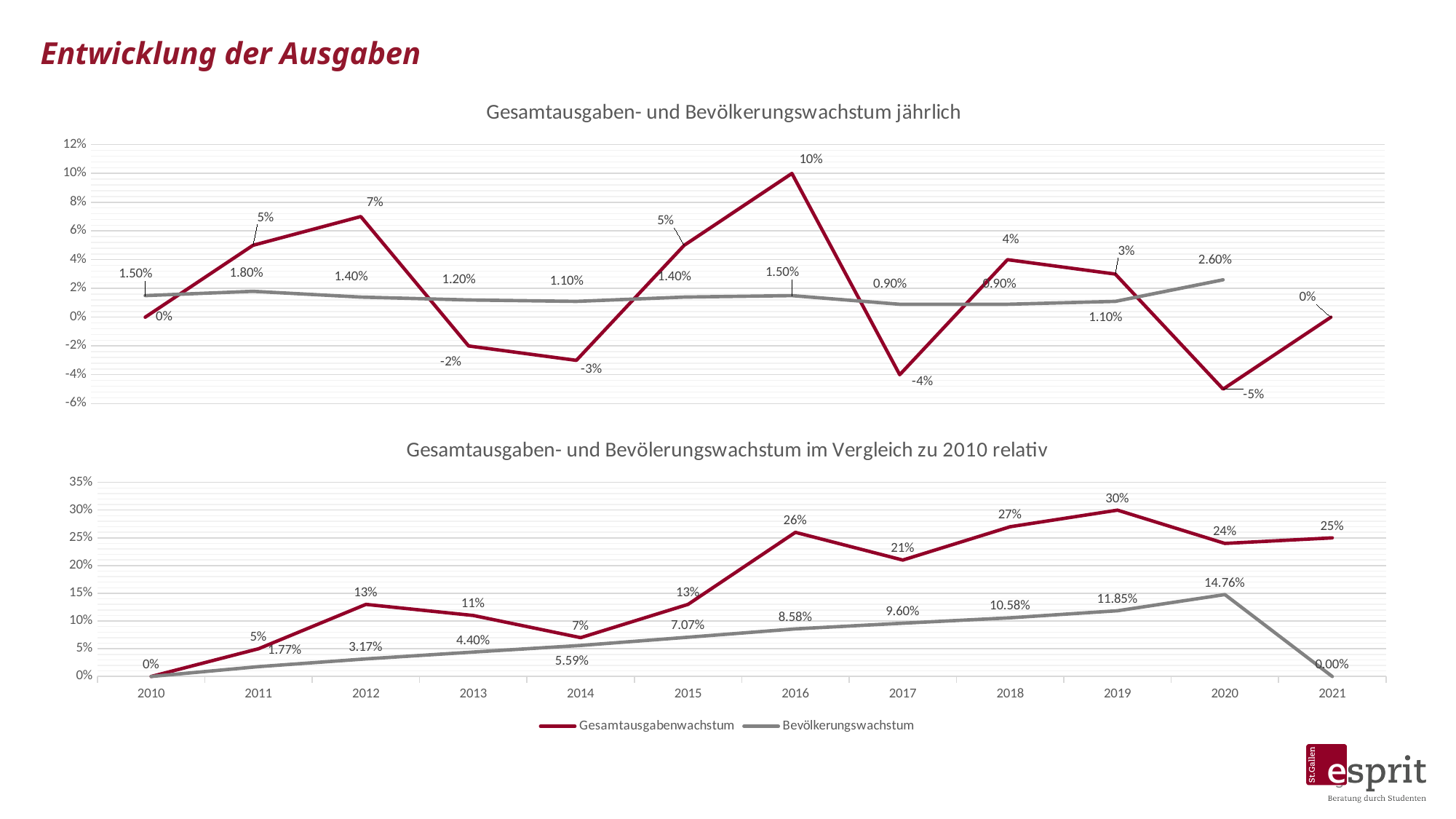
How many series does the legend list? 2 In the top chart (Gesamtausgaben- und Bevölkerungswachstum jährlich), which year has the lowest Gesamtausgabenwachstum? 2020 In the bottom chart (Gesamtausgaben- und Bevölerungswachstum im Vergleich zu 2010 relativ), what is the difference between Gesamtausgabenwachstum and Bevölkerungswachstum in 2020? 9.24 percentage points In the bottom chart (Gesamtausgaben- und Bevölerungswachstum im Vergleich zu 2010 relativ), which is larger in 2017: Gesamtausgabenwachstum or Bevölkerungswachstum? Gesamtausgabenwachstum In the top chart (Gesamtausgaben- und Bevölkerungswachstum jährlich), what is the Bevölkerungswachstum value for 2020? 2.60% In the bottom chart (Gesamtausgaben- und Bevölerungswachstum im Vergleich zu 2010 relativ), what is the Bevölkerungswachstum value for 2019? 11.85% In the top chart (Gesamtausgaben- und Bevölkerungswachstum jährlich), what is the difference between the Gesamtausgabenwachstum in 2012 and in 2013? 9 percentage points What type of chart is the top chart (Gesamtausgaben- und Bevölkerungswachstum jährlich)? Line chart In the top chart (Gesamtausgaben- und Bevölkerungswachstum jährlich), which year has the highest Gesamtausgabenwachstum? 2016 In the top chart (Gesamtausgaben- und Bevölkerungswachstum jährlich), what is the Gesamtausgabenwachstum value for 2016? 10% How many years are shown on the x axis of the bottom chart? 12 In the bottom chart (Gesamtausgaben- und Bevölerungswachstum im Vergleich zu 2010 relativ), which year has the highest Gesamtausgabenwachstum? 2019